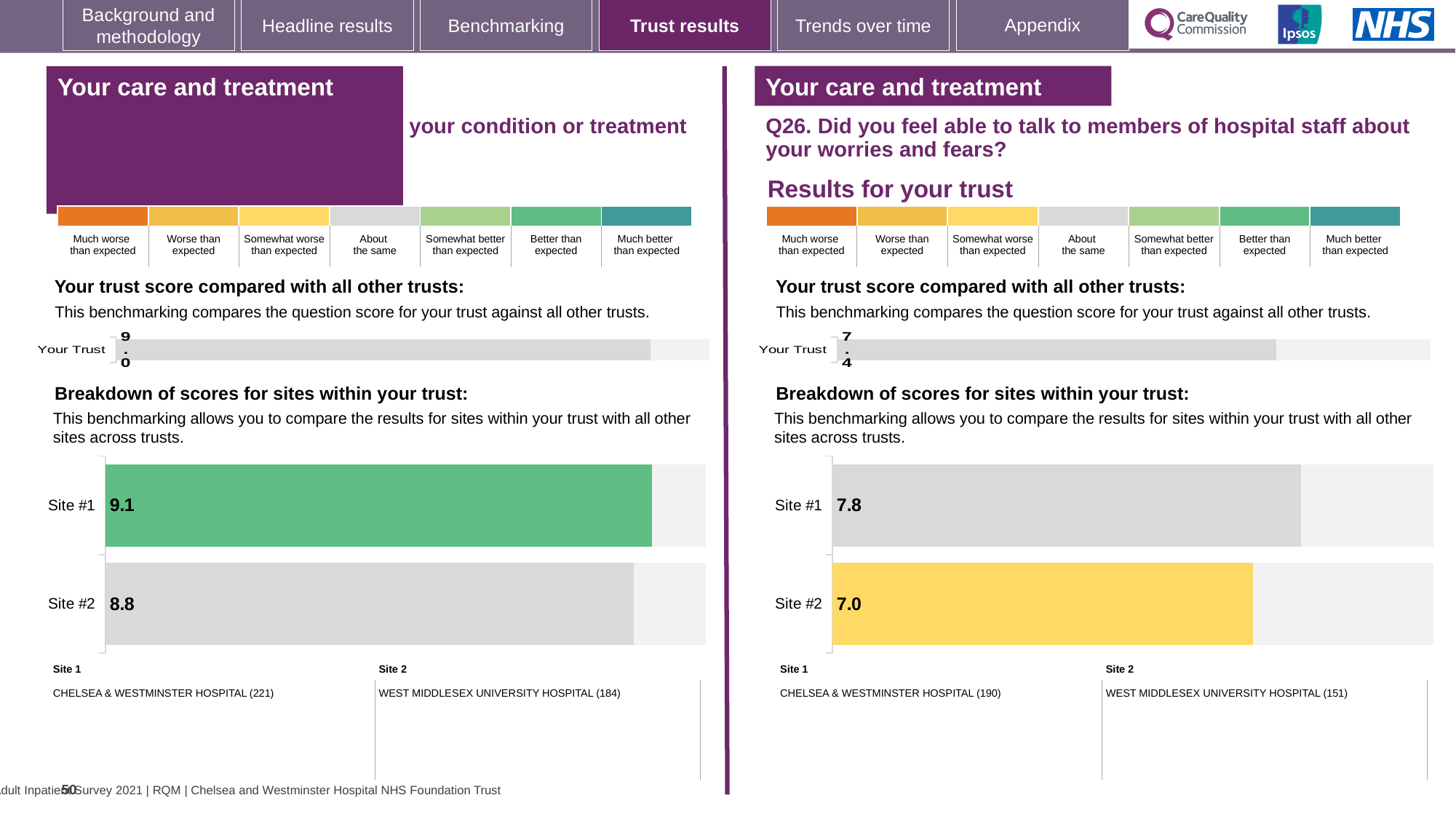
On the left-hand side of the slide, what is the score shown for Site #2 in the breakdown of scores for sites within your trust? 8.8 What type of chart is used for the breakdown of scores for sites within your trust on the left-hand side of the slide? Bar chart On the right-hand side of the slide (Q26), what is the score shown for Site #2 in the breakdown of scores for sites within your trust? 7.0 On the left-hand side of the slide, what is the difference between the Site #1 and Site #2 scores? 0.3 How many sites are shown in the breakdown of scores chart on the right-hand side of the slide (Q26)? 2 On the left-hand side of the slide, what is the 'Your Trust' score in the chart comparing the trust with all other trusts? 9.0 On the right-hand side of the slide (Q26), what is the score shown for Site #1 in the breakdown of scores for sites within your trust? 7.8 On the right-hand side of the slide (Q26), what is the 'Your Trust' score in the chart comparing the trust with all other trusts? 7.4 On the left-hand side of the slide, what is the score shown for Site #1 in the breakdown of scores for sites within your trust? 9.1 On the right-hand side of the slide (Q26), what is the difference between the Site #1 and Site #2 scores? 0.8 On the right-hand side of the slide (Q26), which site has the higher score in the breakdown of scores for sites within your trust? Site #1 On the left-hand side of the slide, which site has the lower score in the breakdown of scores for sites within your trust? Site #2